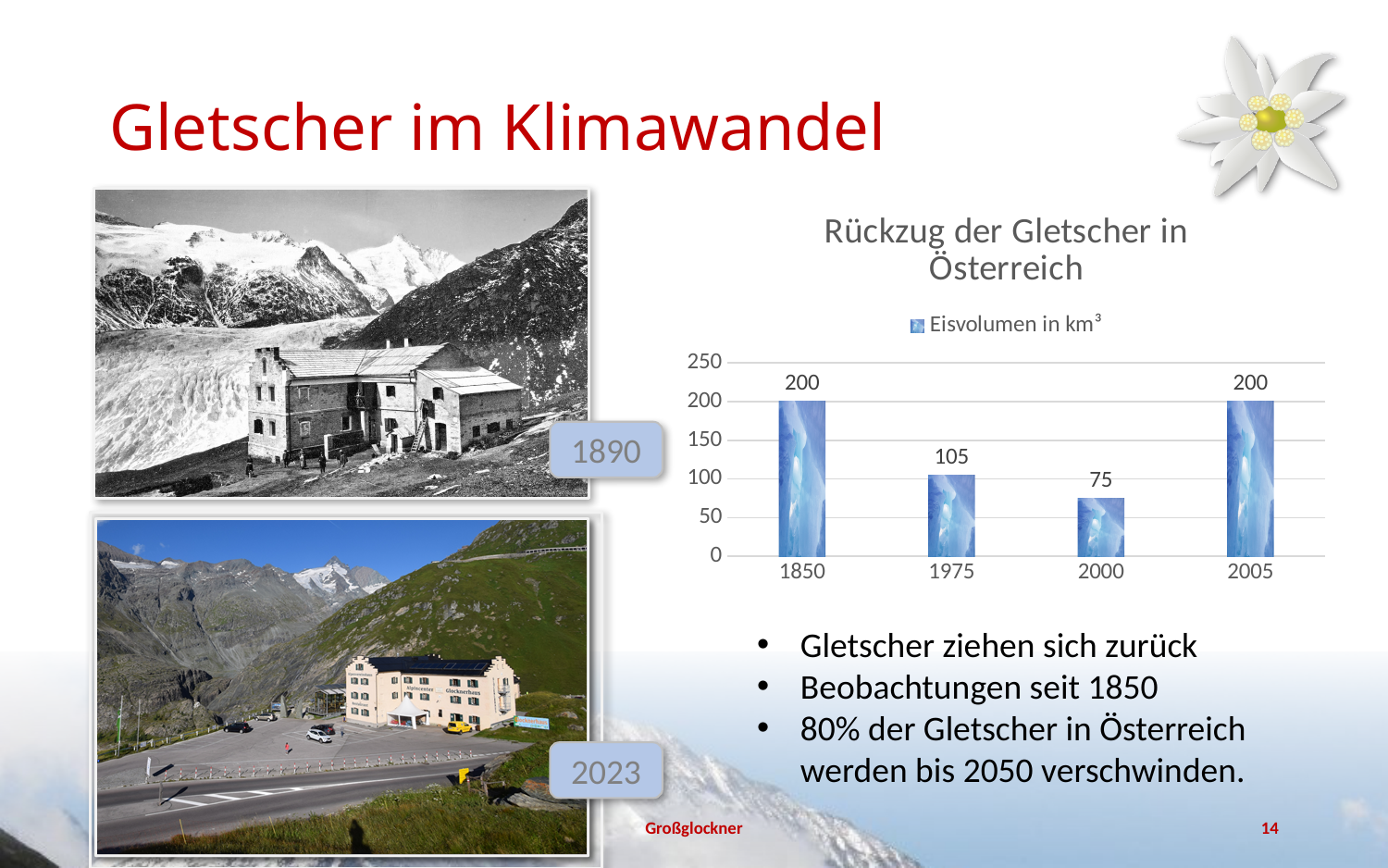
What is the ice volume value shown for 1850? 200 What is the ice volume value shown for 2000? 75 Which year has the lowest ice volume in the chart? 2000 What is the ice volume value shown for 2005? 200 Which is larger, the ice volume for 1975 or for 2000? 1975 Is the value for 2000 greater or less than 100? less What is the difference between the ice volume for 1850 and for 1975? 95 What is the title of the chart? Rückzug der Gletscher in Österreich How many years are shown on the x axis of the chart? 4 What is the ice volume value shown for 1975? 105 What is the difference between the ice volume for 1975 and for 2000? 30 What type of chart is shown on the slide? bar chart